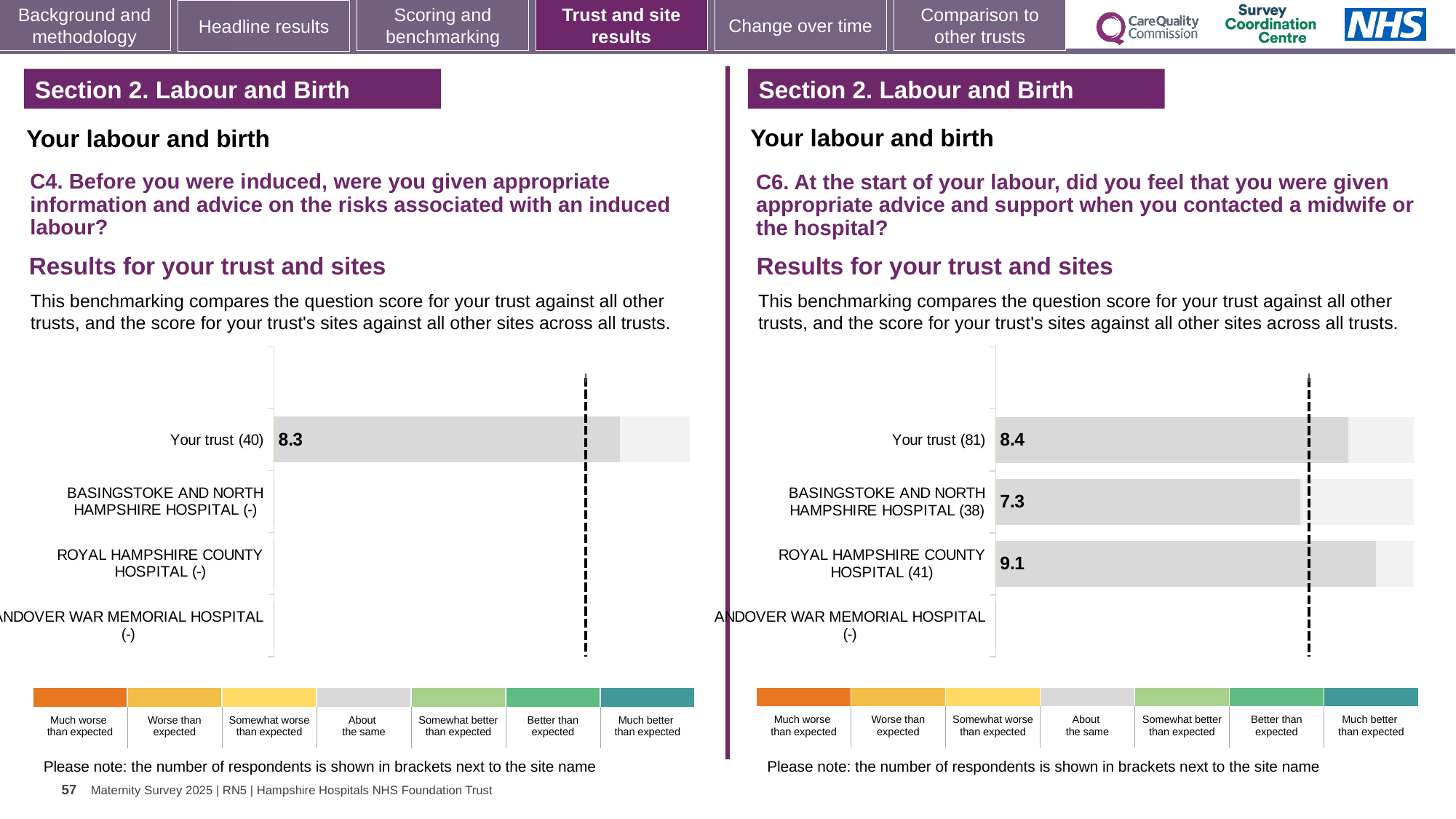
In the C6 chart (right), how many respondents are shown in brackets for Royal Hampshire County Hospital? 41 What kind of chart is the C6 chart (right)? Bar chart In the C6 chart (right), which is larger: the score for Your trust or the score for Basingstoke and North Hampshire Hospital? Your trust In the C6 chart (right), what is the score for Basingstoke and North Hampshire Hospital? 7.3 In the C6 chart (right), what is the difference between the scores for Royal Hampshire County Hospital and Basingstoke and North Hampshire Hospital? 1.8 In the C4 chart (left), what is the score for Your trust? 8.3 In the C4 chart (left), how many respondents are shown in brackets for Your trust? 40 In the C6 chart (right), which site has the highest score? Royal Hampshire County Hospital In the C6 chart (right), which labelled bar has the lowest score? Basingstoke and North Hampshire Hospital How many categories are listed on the y axis of the C4 chart (left)? 4 In the C6 chart (right), what is the score for Your trust? 8.4 In the C6 chart (right), what is the score for Royal Hampshire County Hospital? 9.1